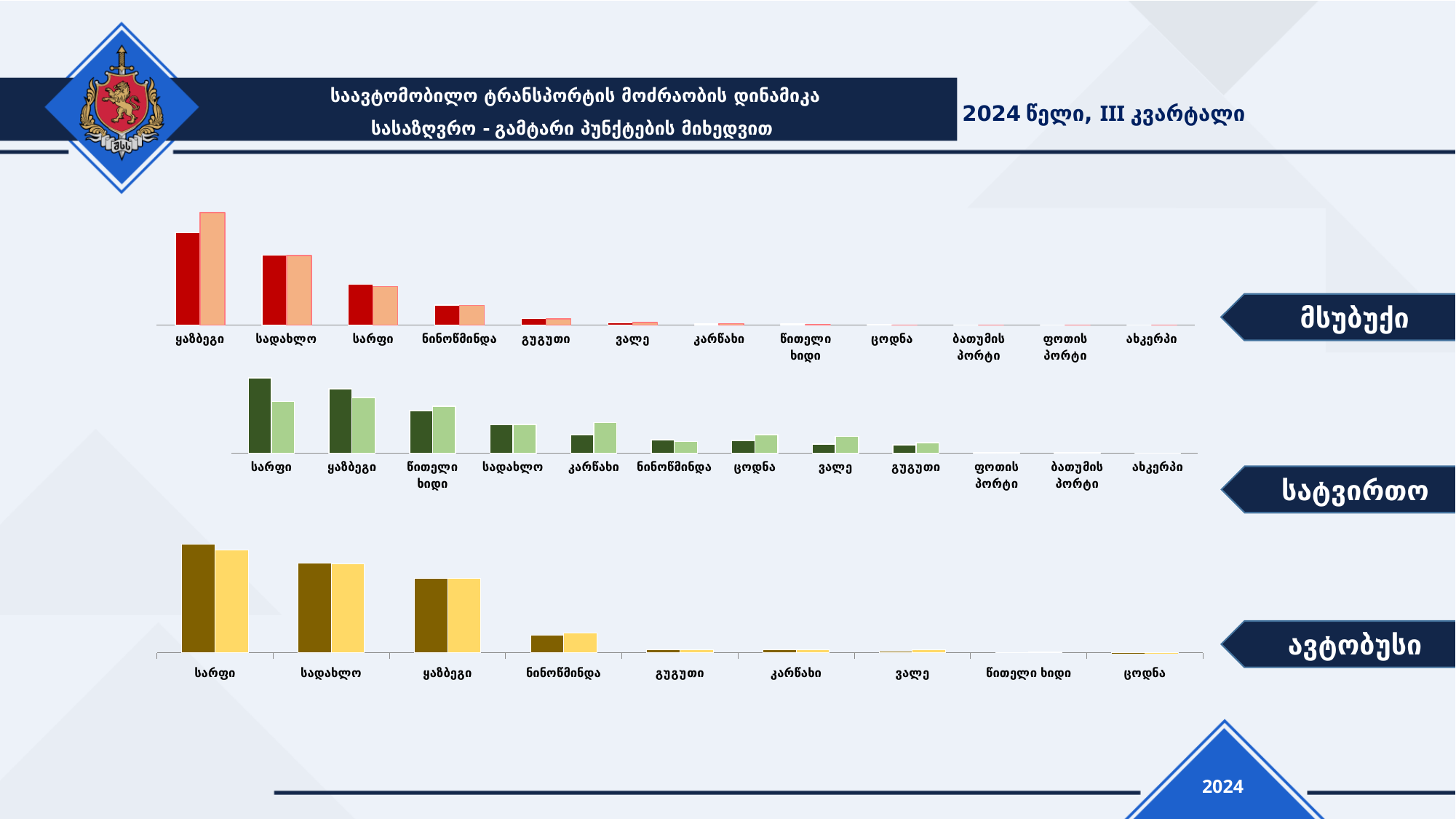
What kind of chart is the "მსუბუქი" chart? bar chart In the "სატვირთო" chart, which is larger, the dark green bar for სარფი or for წითელი ხიდი? სარფი How many categories are shown on the x axis of the "ავტობუსი" chart? 9 In the "ავტობუსი" chart, which is larger, the value for ყაზბეგი or for ნინოწმინდა? ყაზბეგი How many categories are shown on the x axis of the "სატვირთო" chart? 12 How many bars are plotted for each category in the "ავტობუსი" chart? 2 In the "მსუბუქი" chart, do the values rise or fall from left to right along the x axis? fall In the "მსუბუქი" chart, which category has the highest values? ყაზბეგი In the "მსუბუქი" chart, which is larger, the value for ყაზბეგი or for სადახლო? ყაზბეგი In the "სატვირთო" chart, which category has the highest dark green bar? სარფი In the "ავტობუსი" chart, which category has the highest values? სარფი